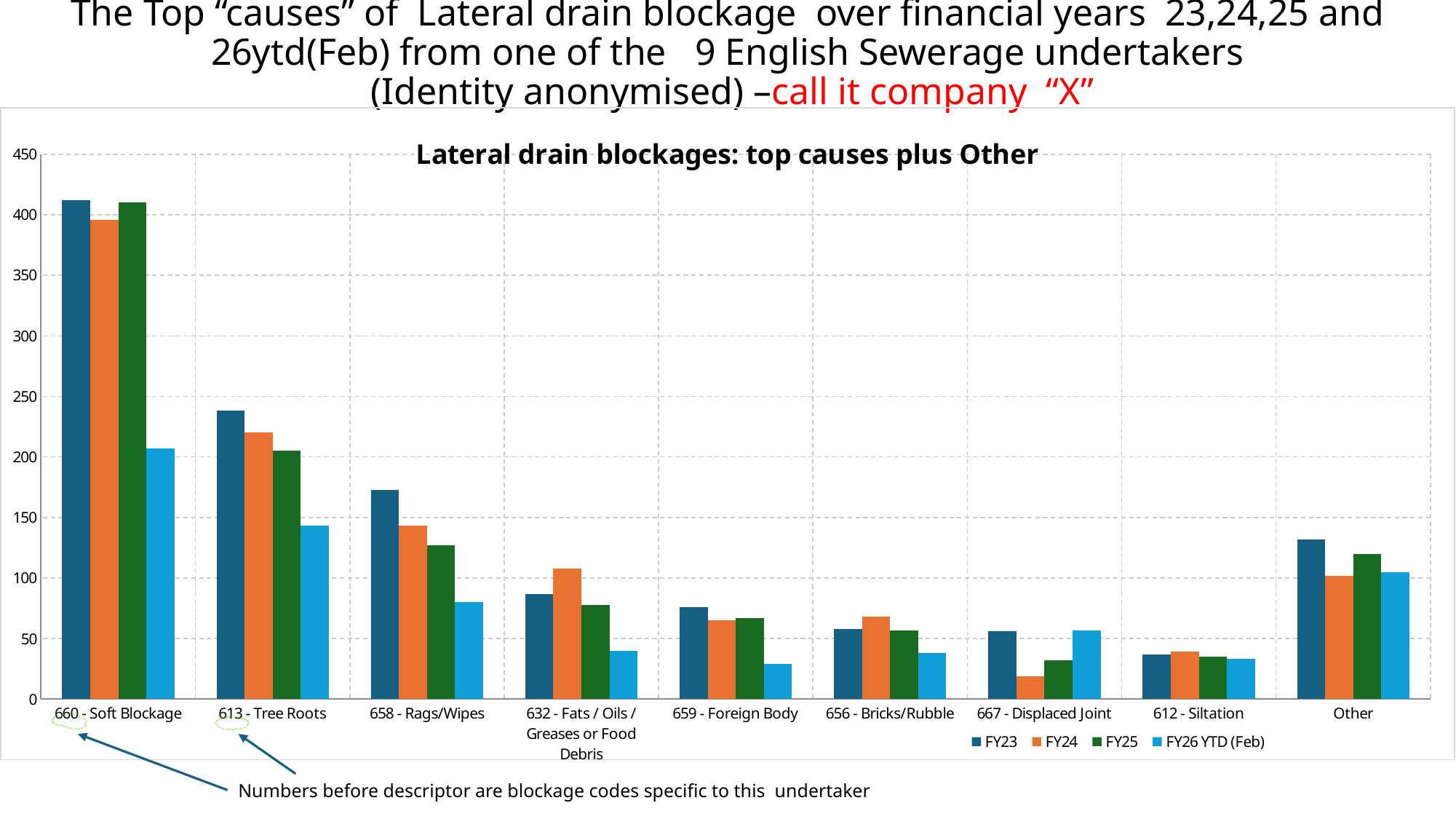
Which category has the highest FY23 value? 660 - Soft Blockage How many categories are shown along the x axis? 9 What is the title of the chart? Lateral drain blockages: top causes plus Other Which category has the lowest FY24 value? 667 - Displaced Joint Is the FY26 YTD (Feb) value for 660 - Soft Blockage greater or less than 250? less For 632 - Fats / Oils / Greases or Food Debris, which is larger: the FY23 value or the FY24 value? FY24 For 658 - Rags/Wipes, do the values rise or fall from FY23 through to FY26 YTD (Feb)? fall For 667 - Displaced Joint, which is larger: the FY24 value or the FY26 YTD (Feb) value? FY26 YTD (Feb) Is the FY23 value for 658 - Rags/Wipes greater or less than 150? greater How many series does the legend list? 4 Is the FY23 value for 660 - Soft Blockage greater or less than 350? greater What kind of chart is shown on the slide? bar chart